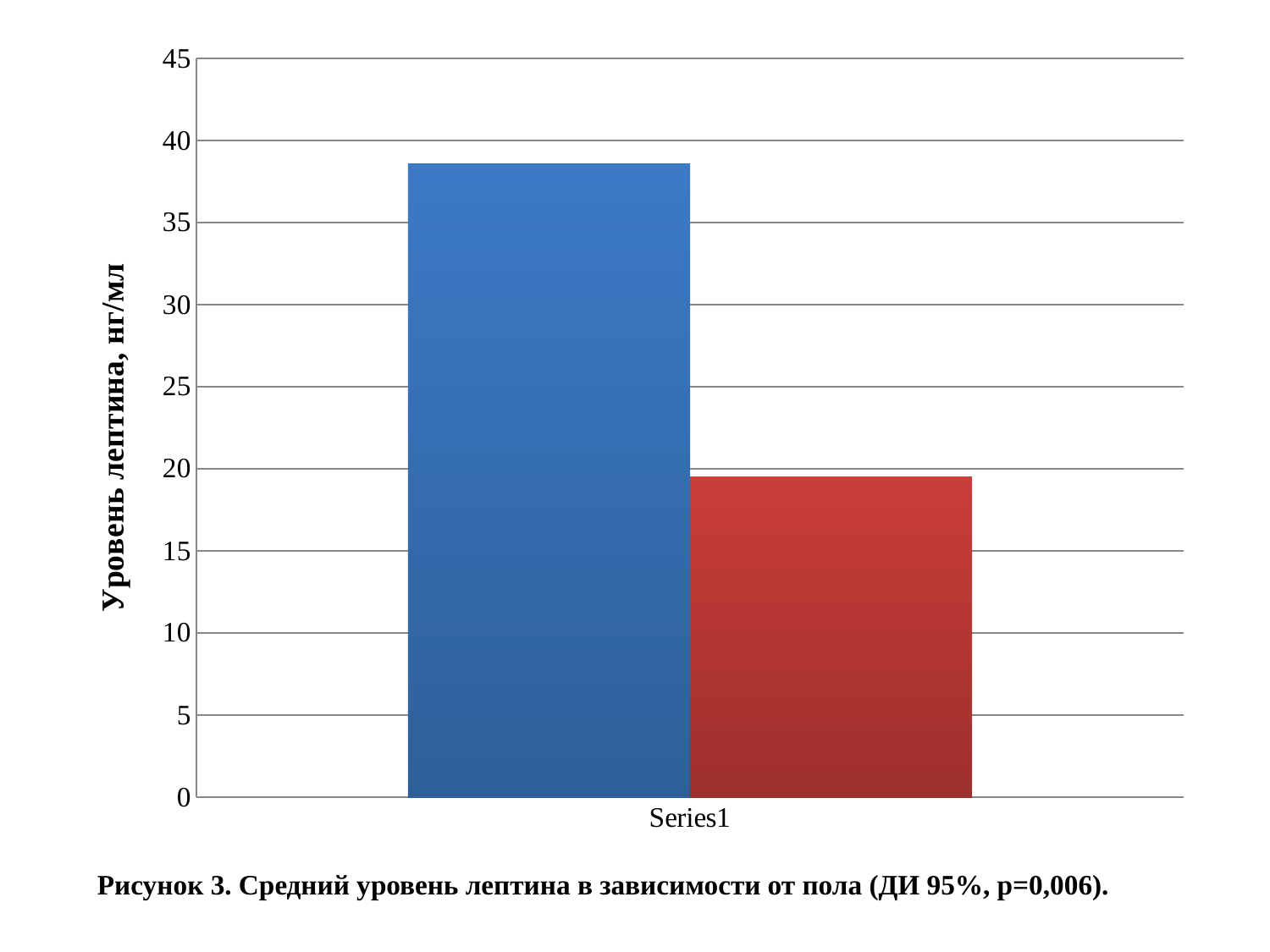
What kind of chart is shown on the slide? bar chart How many bars are plotted in the chart? 2 Which bar has the lowest value in the chart? the red bar What is the label of the vertical axis? Уровень лептина, нг/мл Is the value of the red bar greater or less than 15? greater Is the value of the blue bar greater or less than 40? less Which bar is taller, the blue bar or the red bar? the blue bar What is the highest value shown on the vertical axis? 45 Is the value of the red bar greater or less than 20? less What category label is shown on the horizontal axis? Series1